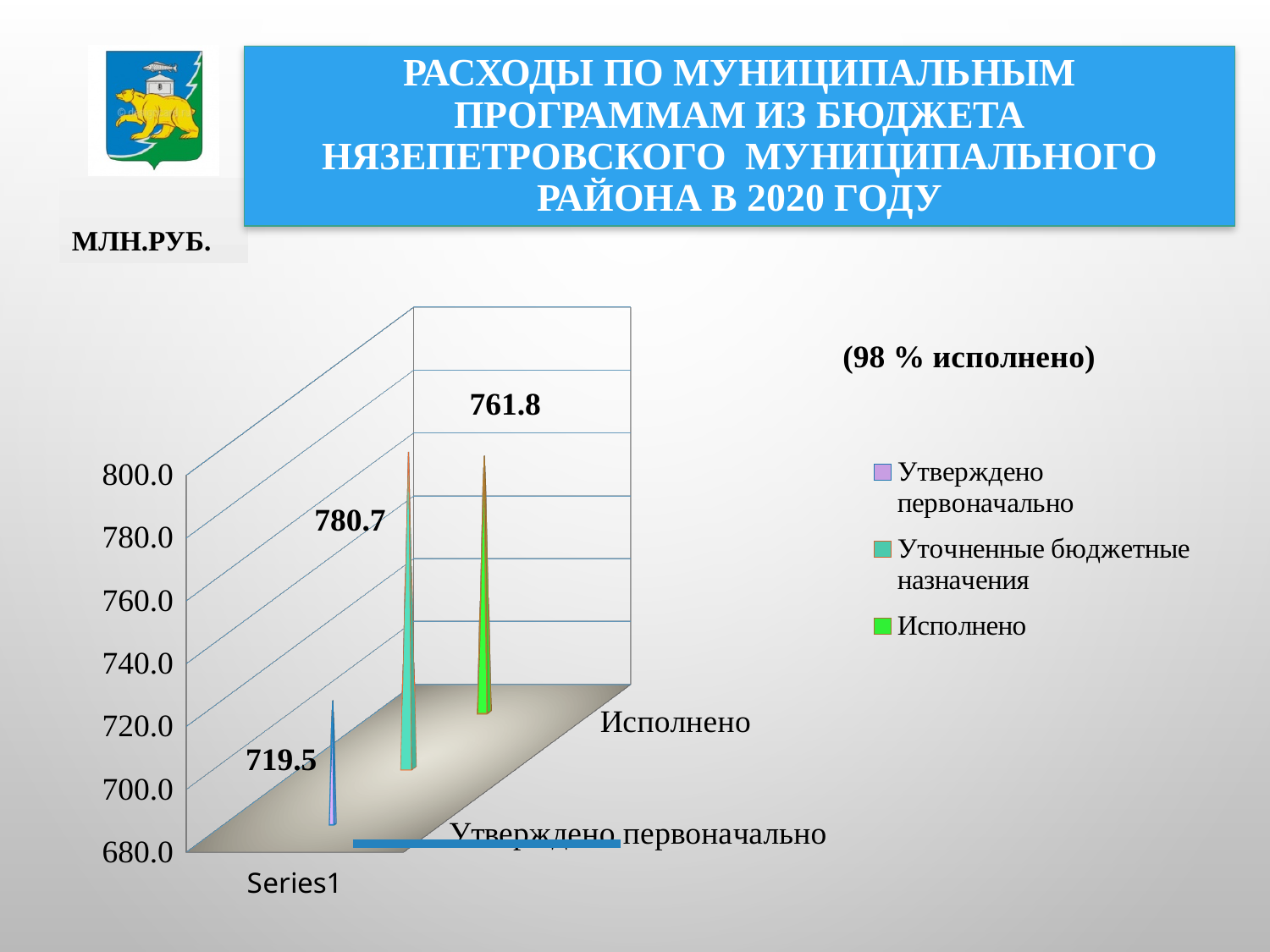
What is the difference between Исполнено and Утверждено первоначально? 42.3 What is the difference between Уточненные бюджетные назначения and Утверждено первоначально? 61.2 Which series has the lowest value? Утверждено первоначально Which is larger, Исполнено or Утверждено первоначально? Исполнено What is the value for Утверждено первоначально? 719.5 What percentage of the budget is stated as executed on the slide? 98 % What is the difference between Уточненные бюджетные назначения and Исполнено? 18.9 What is the value for Исполнено? 761.8 In what units are the chart values given? МЛН.РУБ. Which series has the highest value? Уточненные бюджетные назначения What is the value for Уточненные бюджетные назначения? 780.7 How many series does the legend list? 3